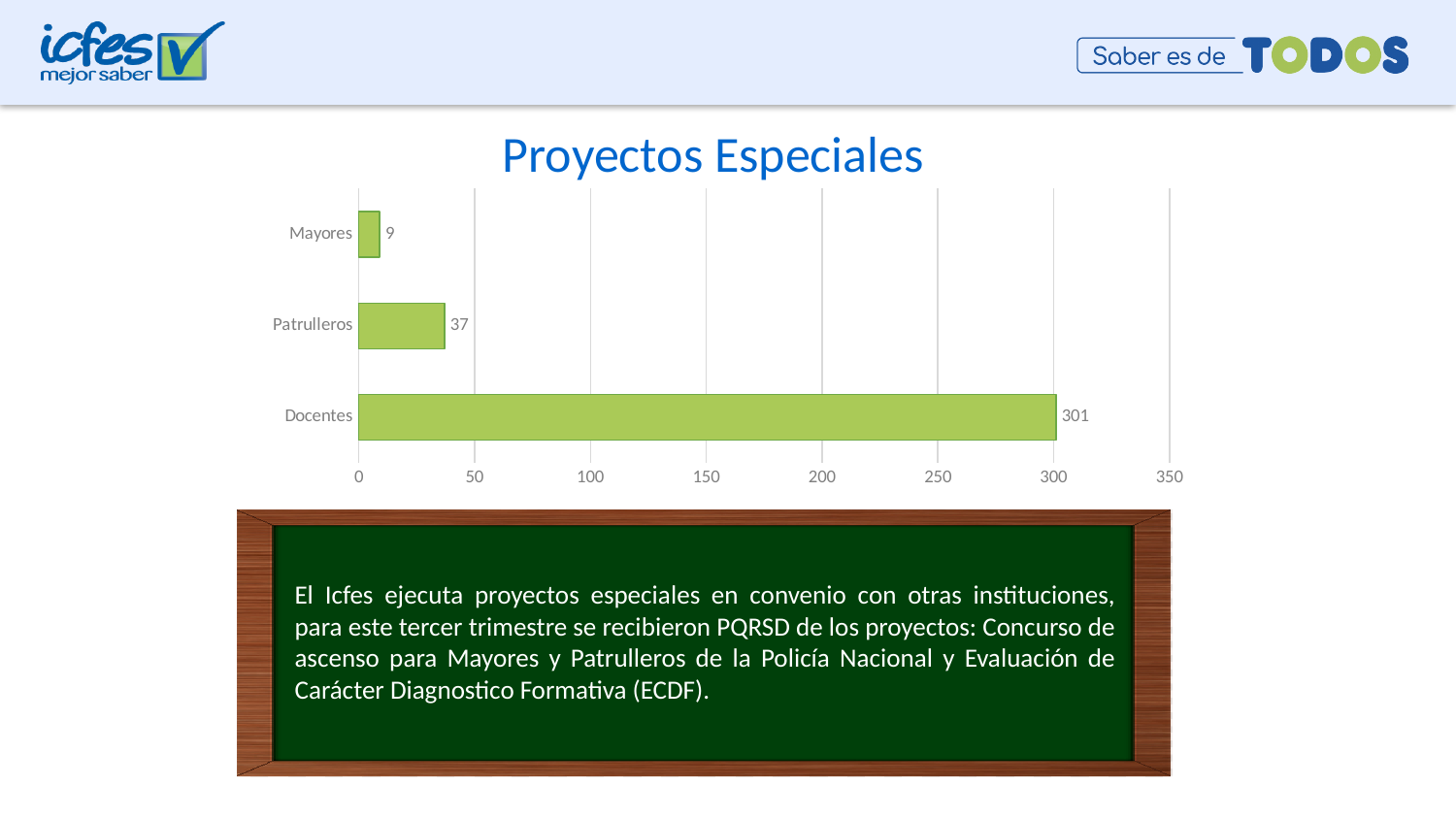
Is the value for Docentes greater or less than 250? greater How many categories are shown in the chart? 3 What is the title of the chart? Proyectos Especiales What is the value for Docentes? 301 What is the value for Mayores? 9 What is the value for Patrulleros? 37 What kind of chart is shown on the slide? bar chart Which category has the highest value? Docentes What is the difference between the values for Docentes and Patrulleros? 264 What is the difference between the values for Patrulleros and Mayores? 28 Which category has the lowest value? Mayores Which is larger, the value for Patrulleros or the value for Mayores? Patrulleros